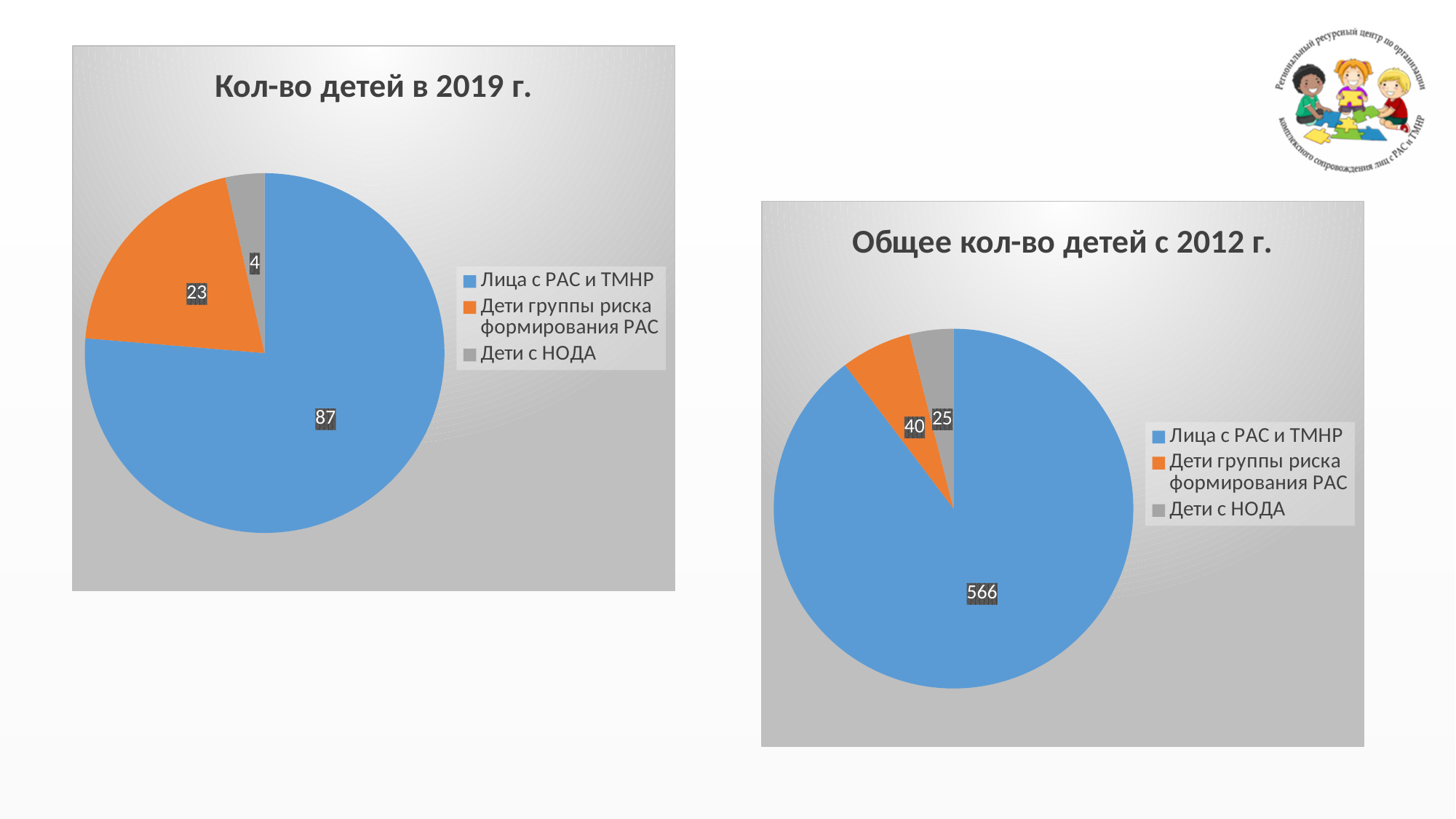
In the chart titled "Кол-во детей в 2019 г.", what is the difference between the values for "Лица с РАС и ТМНР" and "Дети группы риска формирования РАС"? 64 In the chart titled "Кол-во детей в 2019 г.", what is the value for "Дети с НОДА"? 4 In the chart titled "Общее кол-во детей с 2012 г.", what is the value for "Лица с РАС и ТМНР"? 566 What type of chart is the chart titled "Общее кол-во детей с 2012 г."? Pie chart How many slices does the chart titled "Кол-во детей в 2019 г." have? 3 In the chart titled "Общее кол-во детей с 2012 г.", which category has the smallest slice? Дети с НОДА In the chart titled "Кол-во детей в 2019 г.", what colour is the slice for "Дети группы риска формирования РАС"? Orange In the chart titled "Общее кол-во детей с 2012 г.", which is larger: "Дети группы риска формирования РАС" or "Дети с НОДА"? Дети группы риска формирования РАС In the chart titled "Общее кол-во детей с 2012 г.", what is the value for "Дети группы риска формирования РАС"? 40 In the chart titled "Общее кол-во детей с 2012 г.", what is the total of all slices? 631 In the chart titled "Кол-во детей в 2019 г.", what is the value for "Лица с РАС и ТМНР"? 87 In the chart titled "Кол-во детей в 2019 г.", which category has the largest slice? Лица с РАС и ТМНР